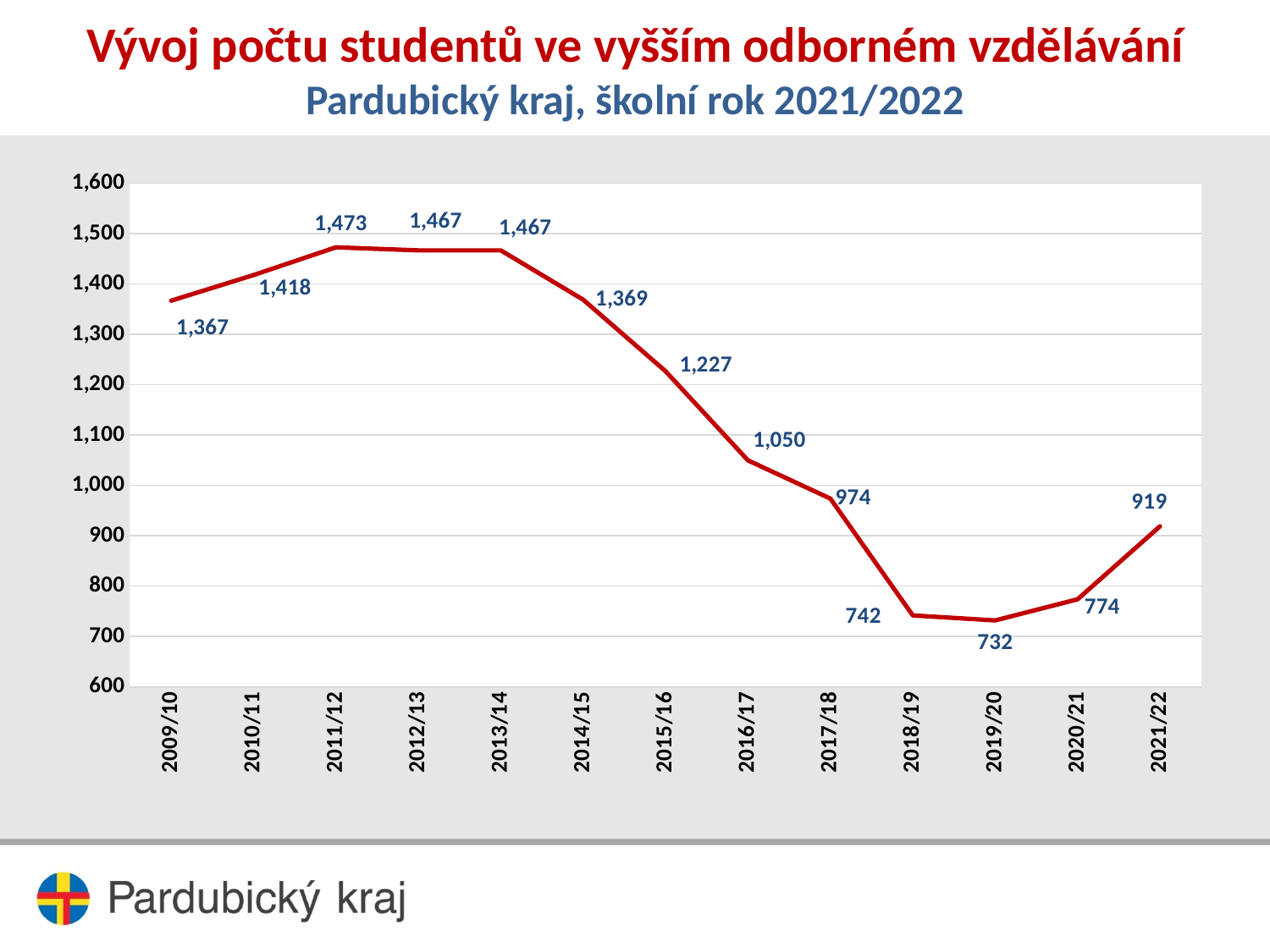
What is the difference between the values for 2020/21 and 2021/22? 145 What is the value for 2016/17? 1,050 What is the number of students in 2009/10? 1,367 Which is larger, the value for 2017/18 or the value for 2021/22? 2017/18 Which school year has the highest number of students? 2011/12 How many school years are plotted on the chart? 13 What is the difference between the values for 2011/12 and 2019/20? 741 What is the number of students in 2021/22? 919 Do the values rise or fall from 2013/14 to 2019/20? Fall What is the title of the chart? Vývoj počtu studentů ve vyšším odborném vzdělávání What kind of chart is shown on the slide? Line chart Which school year has the lowest number of students? 2019/20